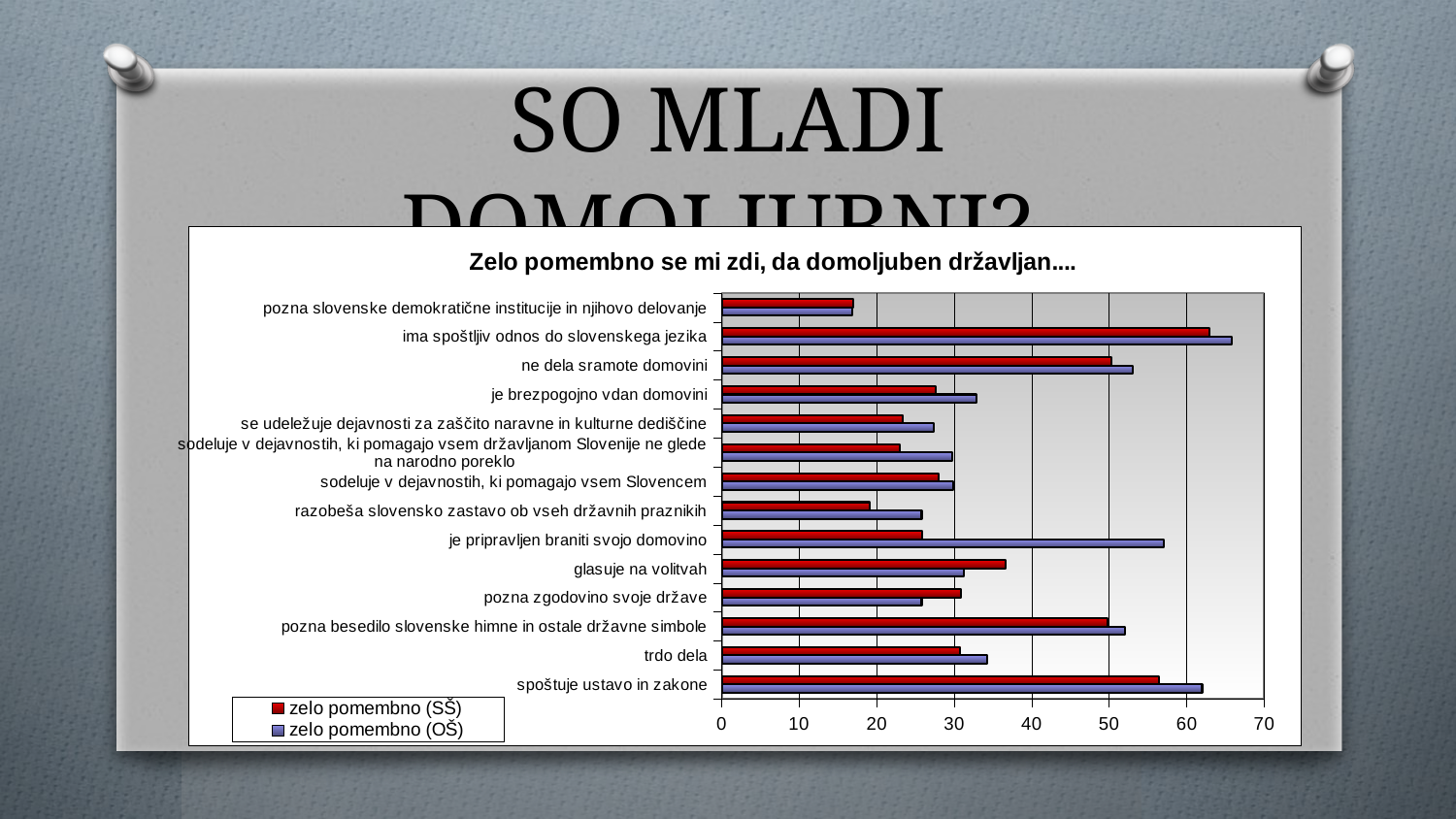
For the category 'je pripravljen braniti svojo domovino', which series has the larger value, 'zelo pomembno (SŠ)' or 'zelo pomembno (OŠ)'? zelo pomembno (OŠ) How many categories are plotted on the chart? 14 Is the value for 'pozna slovenske demokratične institucije in njihovo delovanje' in the series 'zelo pomembno (SŠ)' greater or less than 20? less Is the value for 'spoštuje ustavo in zakone' in the series 'zelo pomembno (OŠ)' greater or less than 60? greater How many series does the legend list? 2 Which colour represents the series 'zelo pomembno (SŠ)' in the chart? red Which category has the lowest value for the series 'zelo pomembno (SŠ)'? pozna slovenske demokratične institucije in njihovo delovanje What kind of chart is shown on the slide? bar chart Is the value for 'je pripravljen braniti svojo domovino' in the series 'zelo pomembno (SŠ)' greater or less than 30? less Which category has the highest value for the series 'zelo pomembno (OŠ)'? ima spoštljiv odnos do slovenskega jezika What is the title of the chart? Zelo pomembno se mi zdi, da domoljuben državljan.... For the category 'glasuje na volitvah', which series has the larger value, 'zelo pomembno (SŠ)' or 'zelo pomembno (OŠ)'? zelo pomembno (SŠ)